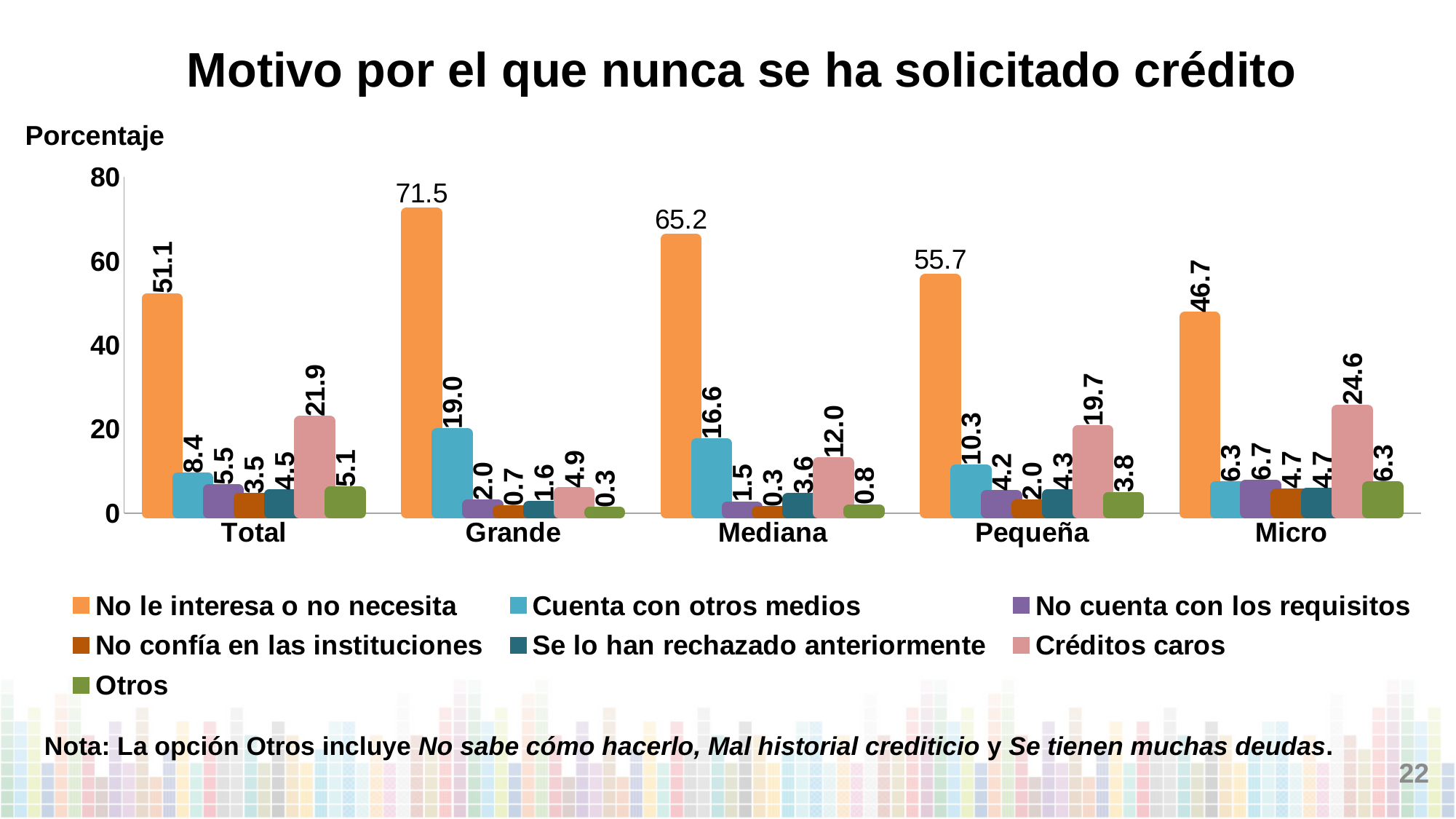
How many categories are shown on the x axis? 5 Is the value for 'No le interesa o no necesita' in the Pequeña category greater or less than 40? greater What is the title of the chart? Motivo por el que nunca se ha solicitado crédito Which is larger: 'Cuenta con otros medios' for Grande or for Mediana? Grande What is the value for 'Cuenta con otros medios' in the Total category? 8.4 What is the value for 'Créditos caros' in the Micro category? 24.6 Which category has the lowest value for 'Créditos caros'? Grande What is the difference between the 'No le interesa o no necesita' values for Grande and Micro? 24.8 Which category has the highest value for 'No le interesa o no necesita'? Grande What is the value for 'No le interesa o no necesita' in the Grande category? 71.5 What kind of chart is shown on the slide? Bar chart How many series does the legend list? 7